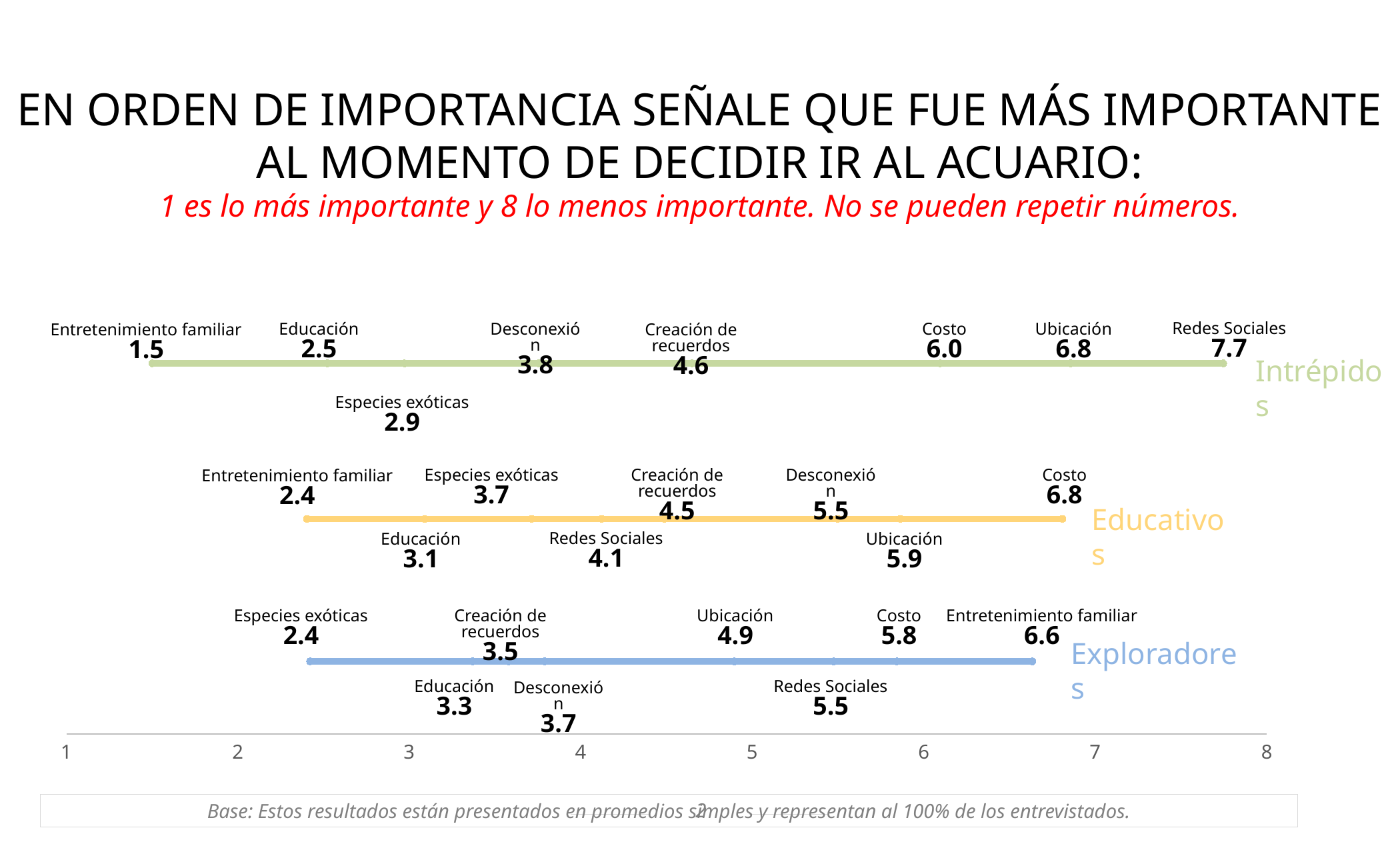
Which category has the highest value in the Intrépidos series? Redes Sociales How many series (segments) are shown on the chart? 3 What is the difference between Costo and Ubicación in the Educativos series? 0.9 What is the value for Redes Sociales in the Exploradores series? 5.5 Which is larger in the Exploradores series: Ubicación or Creación de recuerdos? Ubicación How many categories are plotted in the Educativos series? 8 What is the value for Costo in the Educativos series? 6.8 Which category has the lowest value in the Exploradores series? Especies exóticas What is the value for Entretenimiento familiar in the Intrépidos series? 1.5 What is the value for Desconexión in the Intrépidos series? 3.8 What is the difference between Redes Sociales and Entretenimiento familiar in the Intrépidos series? 6.2 Which category has the lowest value in the Educativos series? Entretenimiento familiar